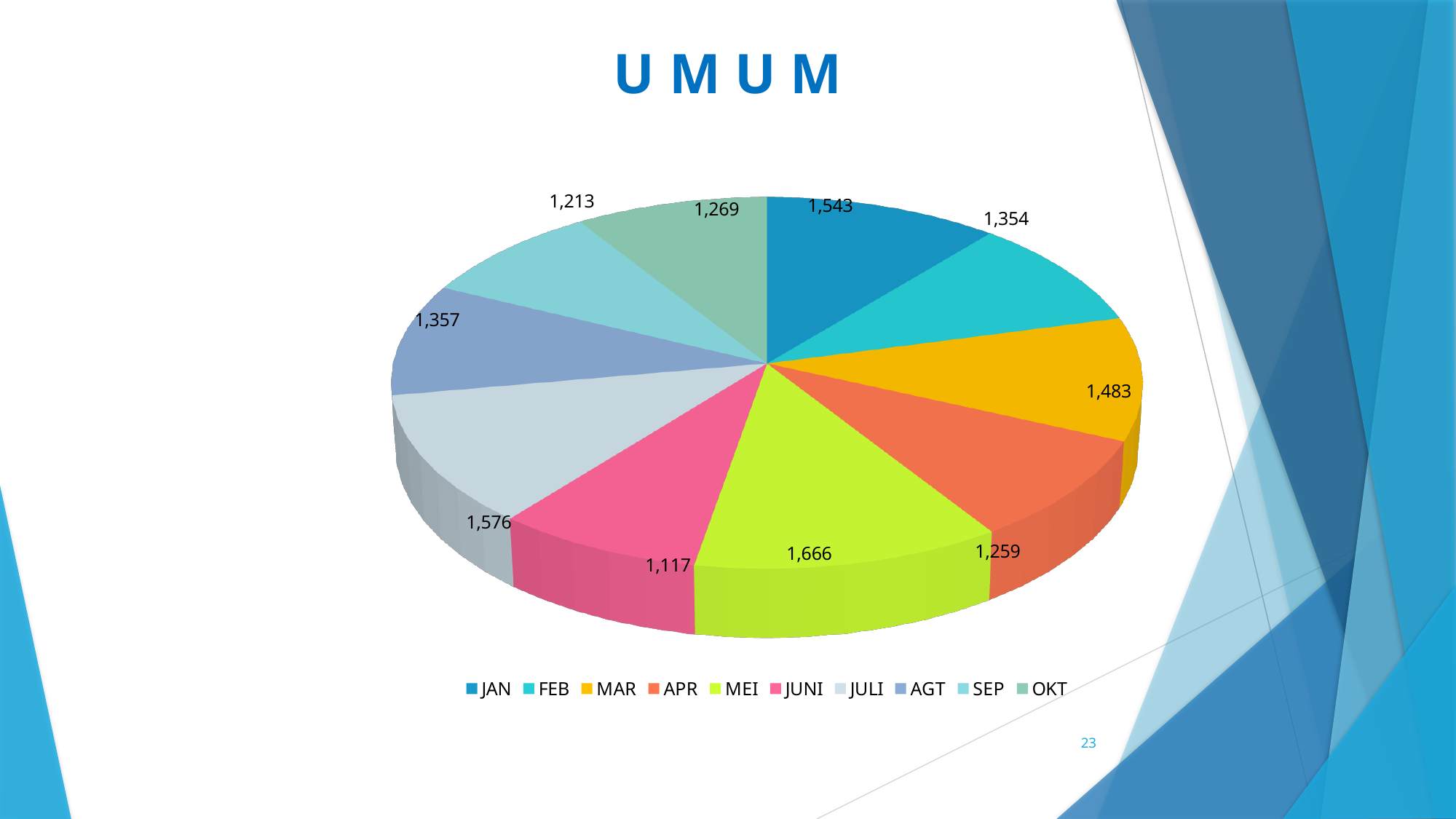
What is the difference between the values for MEI and JUNI? 549 What is the value for JULI in the pie chart? 1,576 Which month has the largest slice in the pie chart? MEI How many categories (months) does the pie chart show? 10 What kind of chart is shown on the slide? Pie chart What is the value for SEP in the pie chart? 1,213 What is the title of the slide containing the chart? UMUM What is the value for MEI in the pie chart? 1,666 Which is larger, the value for JAN or the value for MAR? JAN What is the difference between the values for JAN and FEB? 189 Which month has the smallest slice in the pie chart? JUNI What is the value for JAN in the pie chart? 1,543